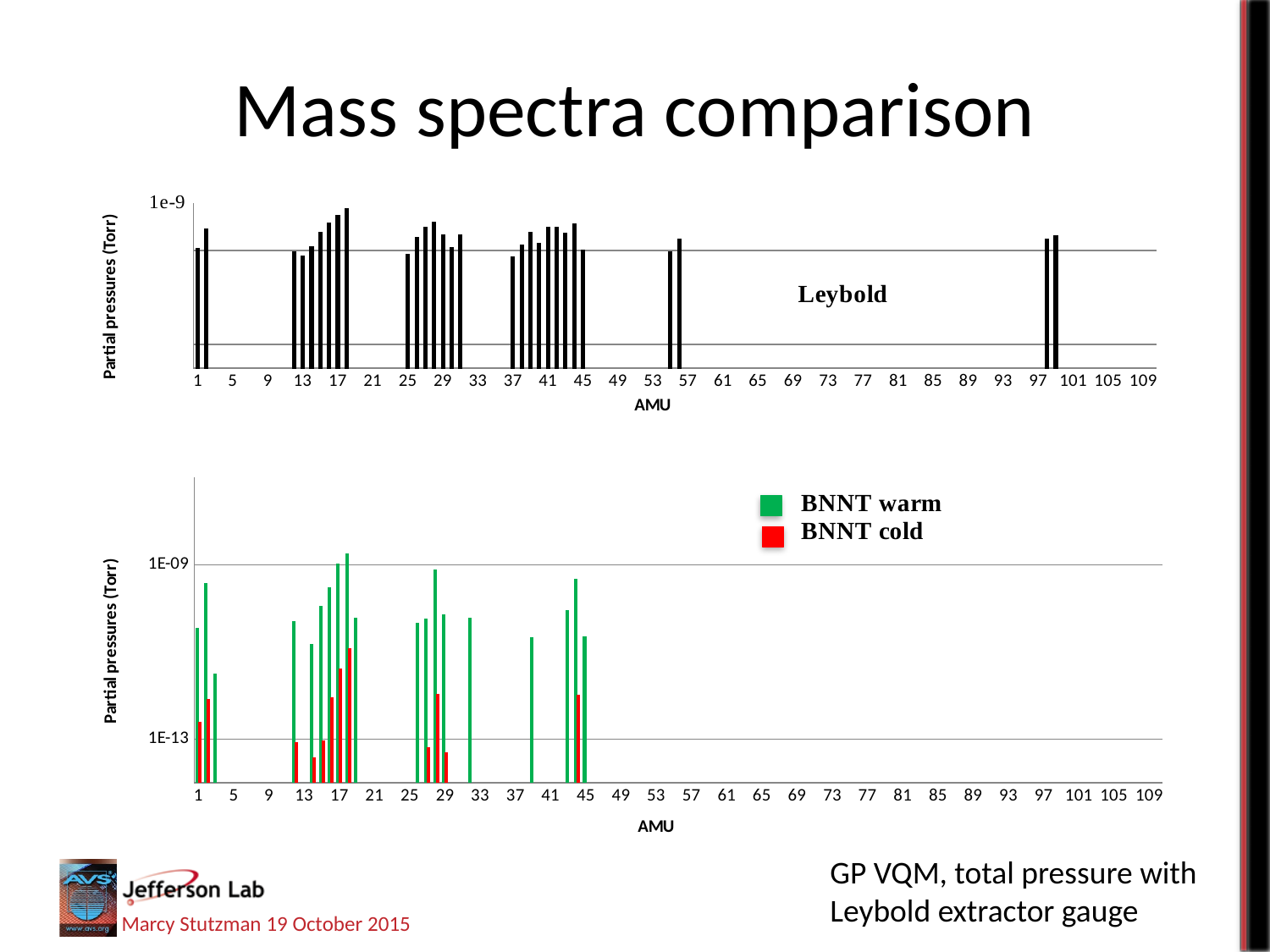
How many series does the legend of the bottom chart list? 2 What is the x-axis label of the top chart? AMU In the bottom chart, at AMU 1, which is larger, the BNNT warm value or the BNNT cold value? BNNT warm What kind of chart is the bottom chart on the slide? bar chart In the bottom chart, is the highest BNNT warm value greater or less than 1E-09? greater What kind of chart is the top chart on the slide? bar chart In the bottom chart, which series is shown in red? BNNT cold In the bottom chart, which series is shown in green? BNNT warm In the bottom chart, which series generally has the higher values, BNNT warm or BNNT cold? BNNT warm In the bottom chart, are the BNNT cold values greater or less than 1E-09? less